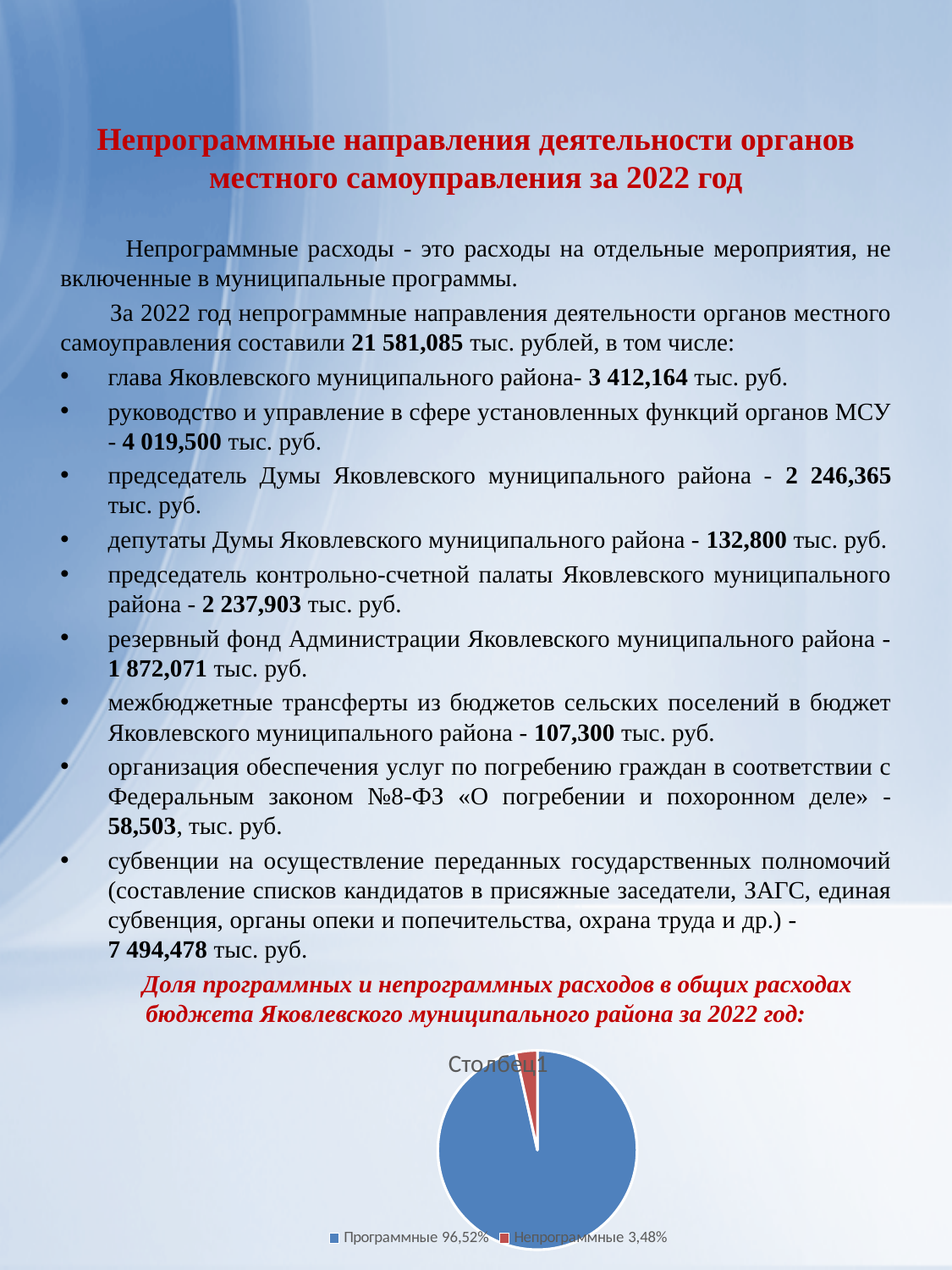
What is the difference between the Программные share and the Непрограммные share in the pie chart? 93,04% What kind of chart is shown on the slide? pie chart What is the title shown above the pie chart? Столбец1 What share of the pie does the Непрограммные slice represent? 3,48% How many slices does the pie chart have? 2 Which slice of the pie chart is the smallest? Непрограммные What colour is the Непрограммные slice in the pie chart? red How many entries does the legend of the pie chart list? 2 What share of the pie does the Программные slice represent? 96,52% Which slice of the pie chart is the largest? Программные Which is larger in the pie chart, Программные or Непрограммные? Программные